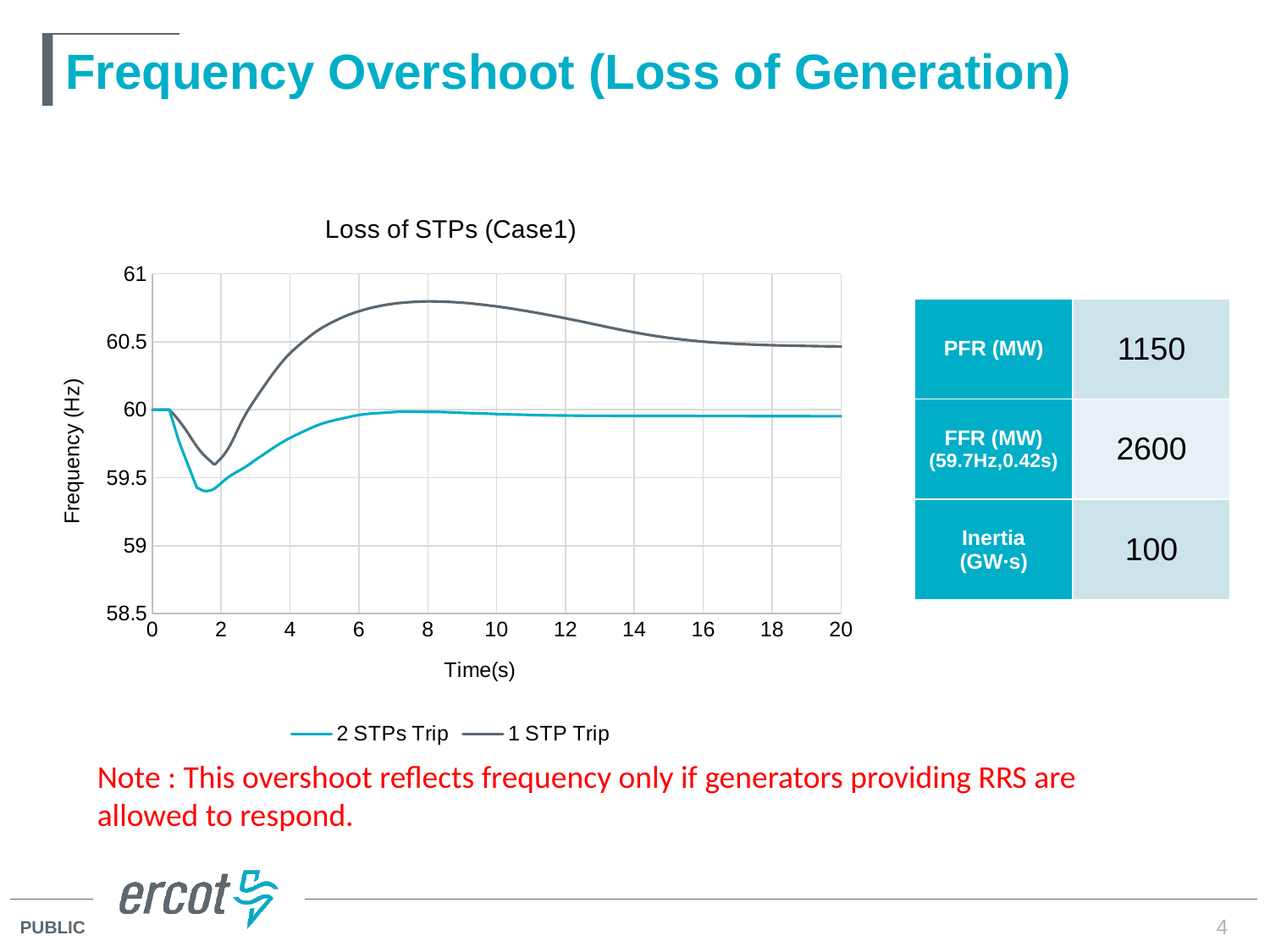
What is the label of the chart's vertical axis? Frequency (Hz) Is the minimum value of the 1 STP Trip series greater or less than 59.5? greater Is the peak value of the 1 STP Trip series greater or less than 60.5? greater What frequency value do both series start at when time is 0? 60 What is the title of the chart? Loss of STPs (Case1) Which series reaches the higher peak frequency, 2 STPs Trip or 1 STP Trip? 1 STP Trip What kind of chart is shown on the slide? line chart Is the value of the 1 STP Trip series at 20 seconds greater or less than 60? greater How many series does the chart legend list? 2 Does the 1 STP Trip series rise or fall between 2 and 8 seconds? rise Which series dips to the lower minimum frequency, 2 STPs Trip or 1 STP Trip? 2 STPs Trip